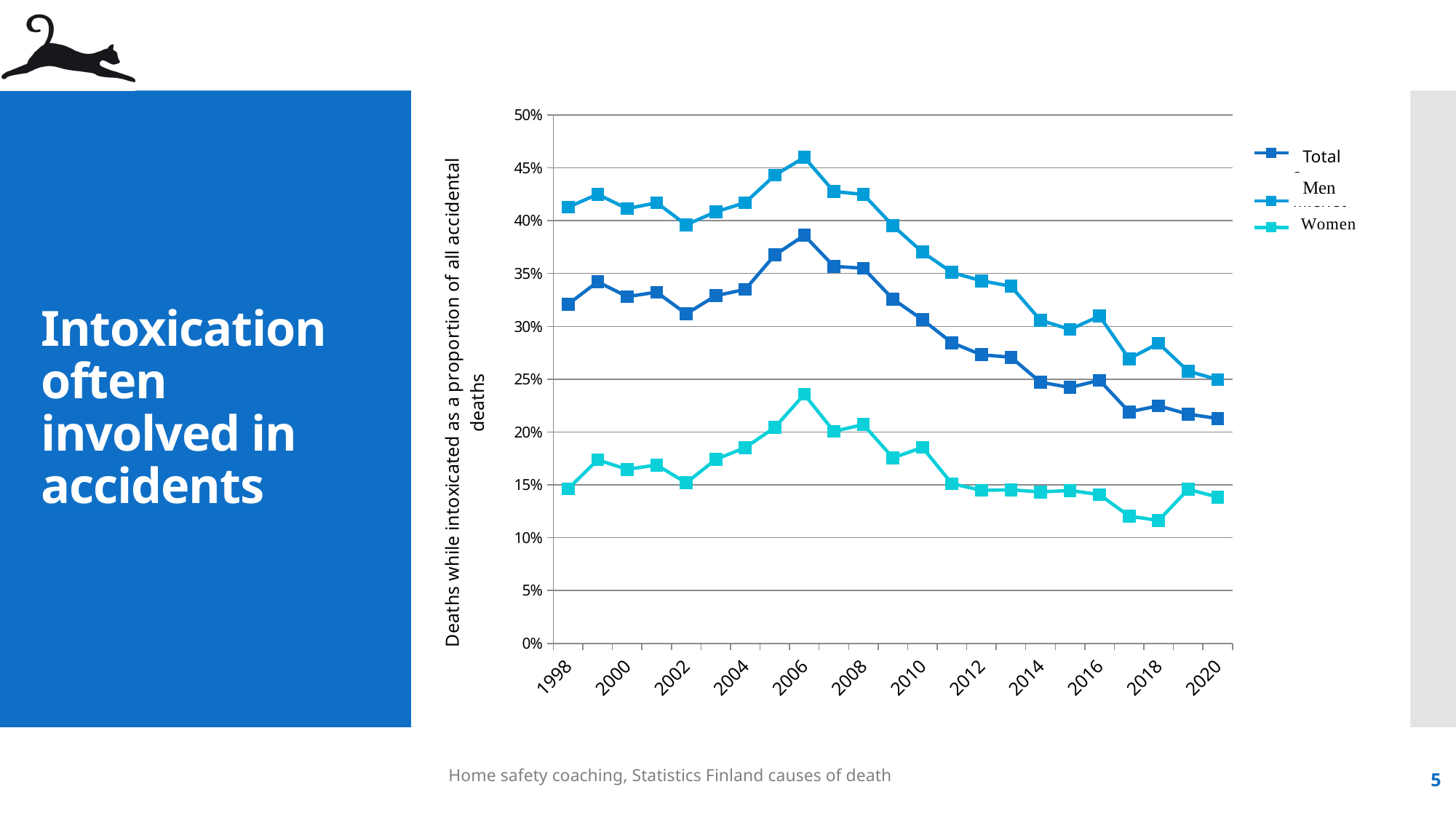
Is the value for Total in 1998 greater or less than 30%? greater Is the value for Men in 2006 greater or less than 45%? greater How many series does the legend list? 3 What kind of chart is shown on the slide? line chart Which series has the larger value in 2010, Men or Women? Men From 2006 to 2020, does the Total series generally rise or fall? fall What are the three series named in the legend? Total, Men, Women In which year does the Total series reach its highest value? 2006 In which year does the Men series reach its highest value? 2006 What is the title of the vertical axis? Deaths while intoxicated as a proportion of all accidental deaths Is the value for Women in 2018 greater or less than 15%? less In which year does the Women series reach its highest value? 2006